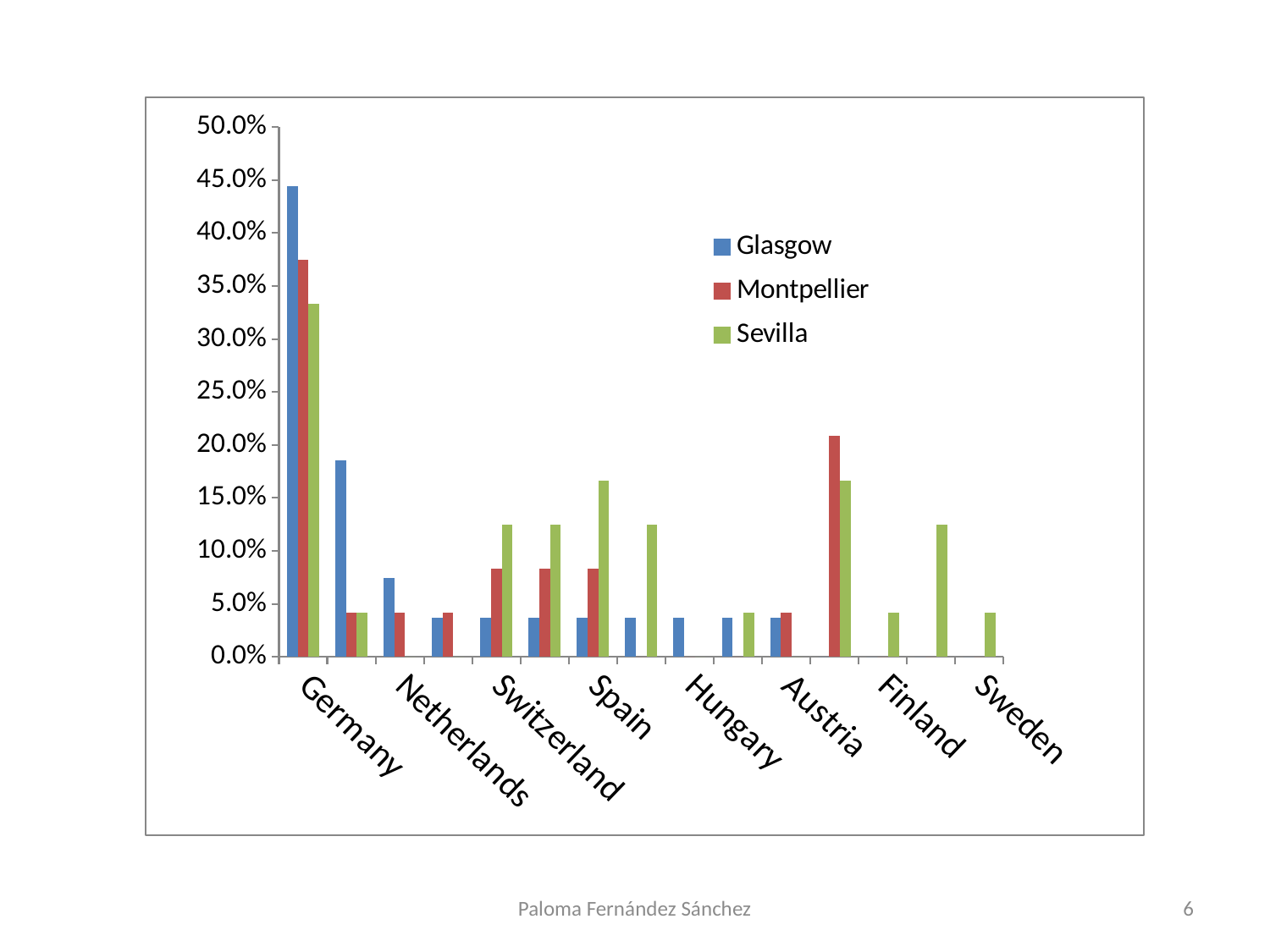
Is the Sevilla value for Finland greater or less than 10.0%? less For Spain, which is larger: the Sevilla value or the Montpellier value? Sevilla How many series does the legend list? 3 Is the Glasgow value for Netherlands greater or less than 10.0%? less Which series has the highest value for Germany? Glasgow Is the Sevilla value for Germany greater or less than 35.0%? less For Germany, which is larger: the Glasgow value or the Montpellier value? Glasgow What colour represents the Sevilla series in the legend? green Which country has the highest value for the Glasgow series? Germany What kind of chart is shown on the slide? bar chart Which series has the highest value for Austria? Montpellier